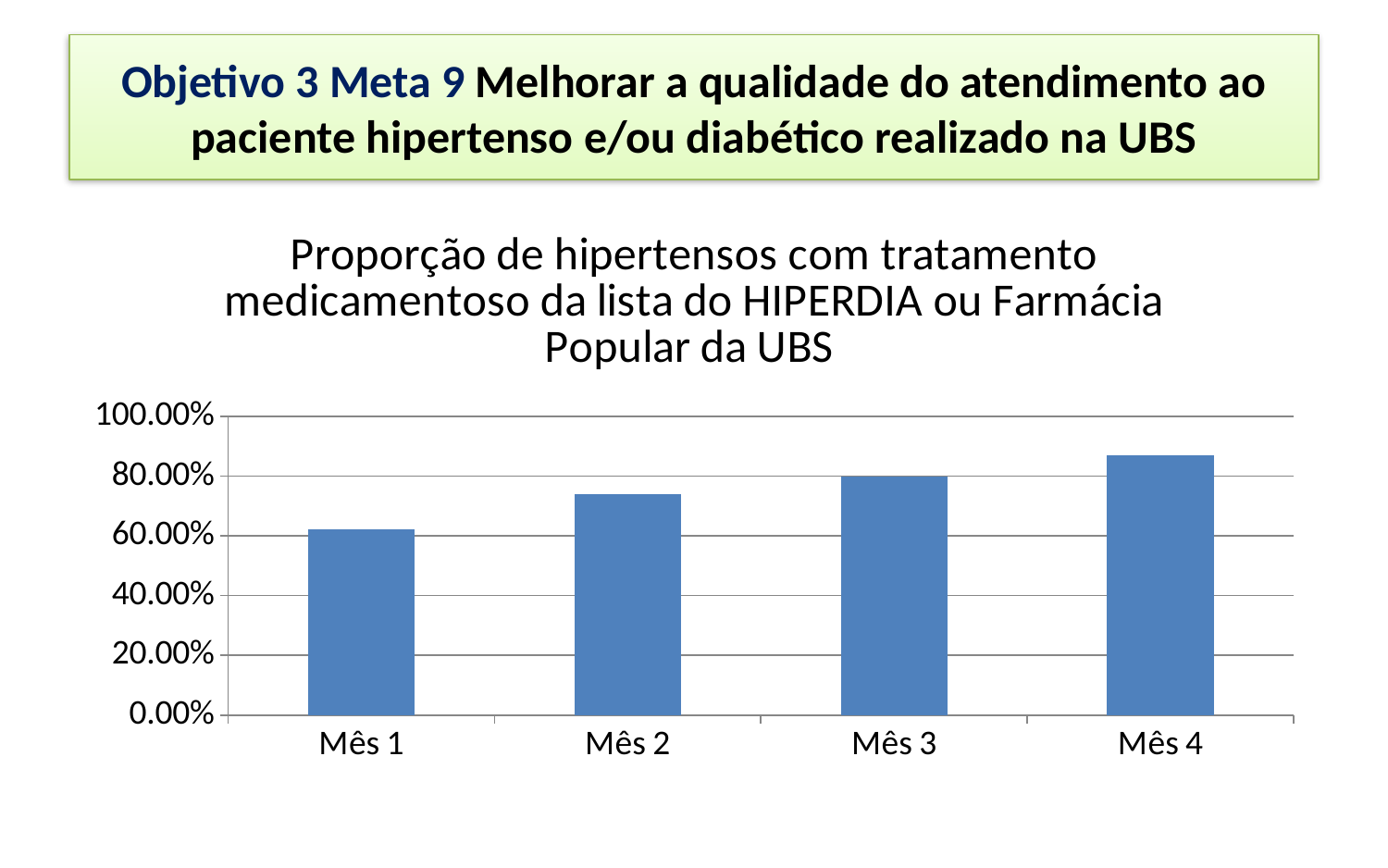
Is the value for Mês 4 greater or less than 80.00%? greater Do the values rise or fall from Mês 1 to Mês 4? rise Which month has the lowest proportion of hypertensive patients with medication treatment? Mês 1 What kind of chart is shown on the slide? bar chart Which month has the highest proportion of hypertensive patients with medication treatment? Mês 4 How many months (categories) are plotted on the chart? 4 Is the value for Mês 2 greater or less than 80.00%? less Is the value for Mês 1 greater or less than 80.00%? less Which is larger, the value for Mês 1 or the value for Mês 3? Mês 3 What is the title of the chart? Proporção de hipertensos com tratamento medicamentoso da lista do HIPERDIA ou Farmácia Popular da UBS Which is larger, the value for Mês 2 or the value for Mês 4? Mês 4